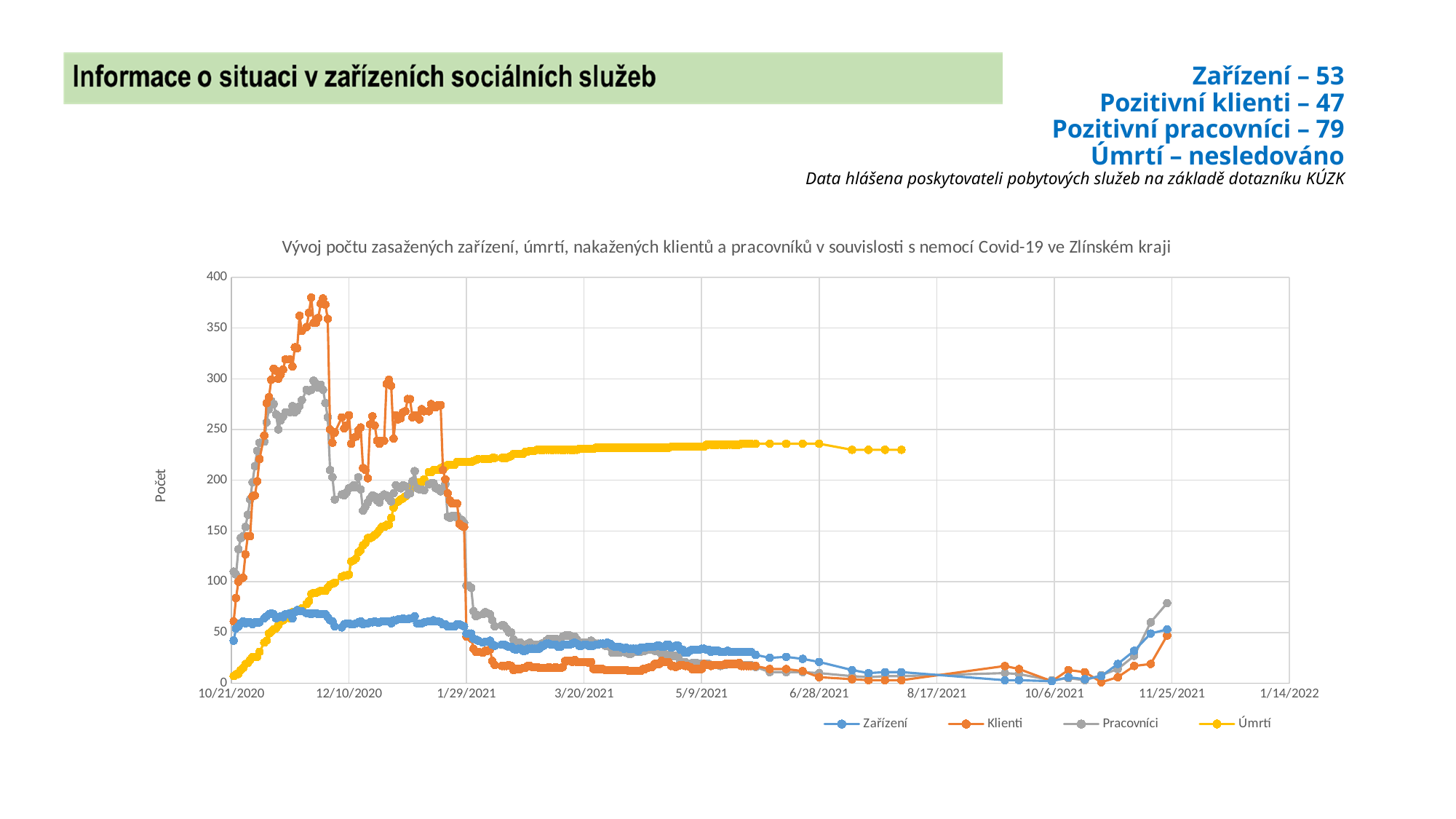
What is the label of the vertical axis of the chart? Počet What kind of chart is shown on the slide? line chart Which series has the higher peak value, Klienti or Pracovníci? Klienti Is the peak value of the Klienti series greater or less than 350? greater Is the highest value of the Zařízení series greater or less than 100? less Does the Klienti series rise or fall between 1/29/2021 and 3/20/2021? fall Which series reaches the highest value on the chart? Klienti How many series does the chart legend list? 4 Is the last plotted value of the Úmrtí series greater or less than 200? greater Does the Úmrtí series generally rise or fall from 10/21/2020 to 6/28/2021? rise Which series are listed in the chart legend? Zařízení, Klienti, Pracovníci, Úmrtí